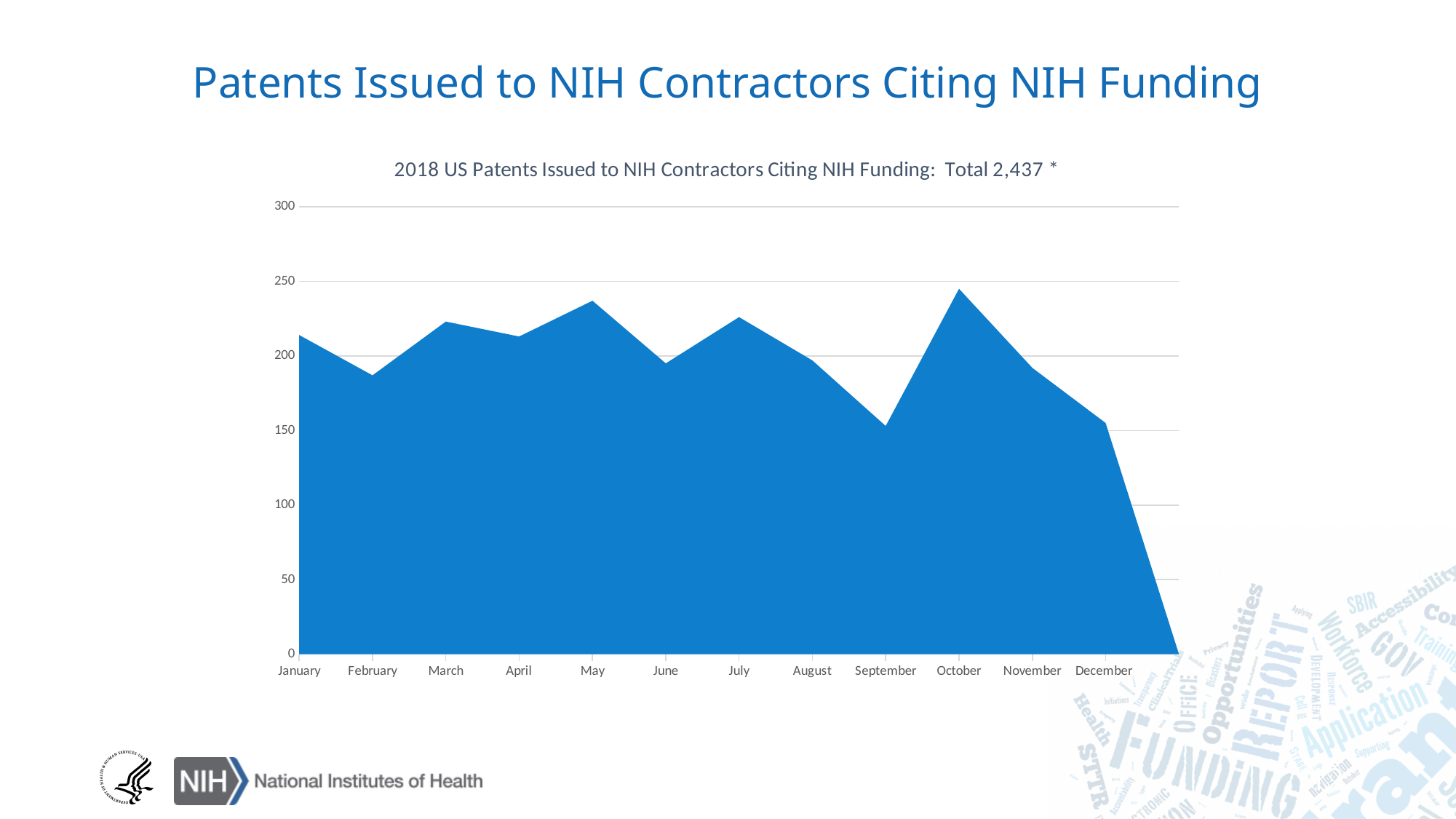
Is the value for December greater or less than 200? less Which month has the larger value, October or September? October Which month has the larger value, May or February? May Which month has the highest number of patents issued? October How many months are labeled on the x axis of the chart? 12 What kind of chart is shown on the slide? Area chart What total number of patents is stated in the chart title? 2,437 Is the value for October greater or less than 200? greater Is the value for May greater or less than 200? greater Do the values rise or fall from October to December? fall